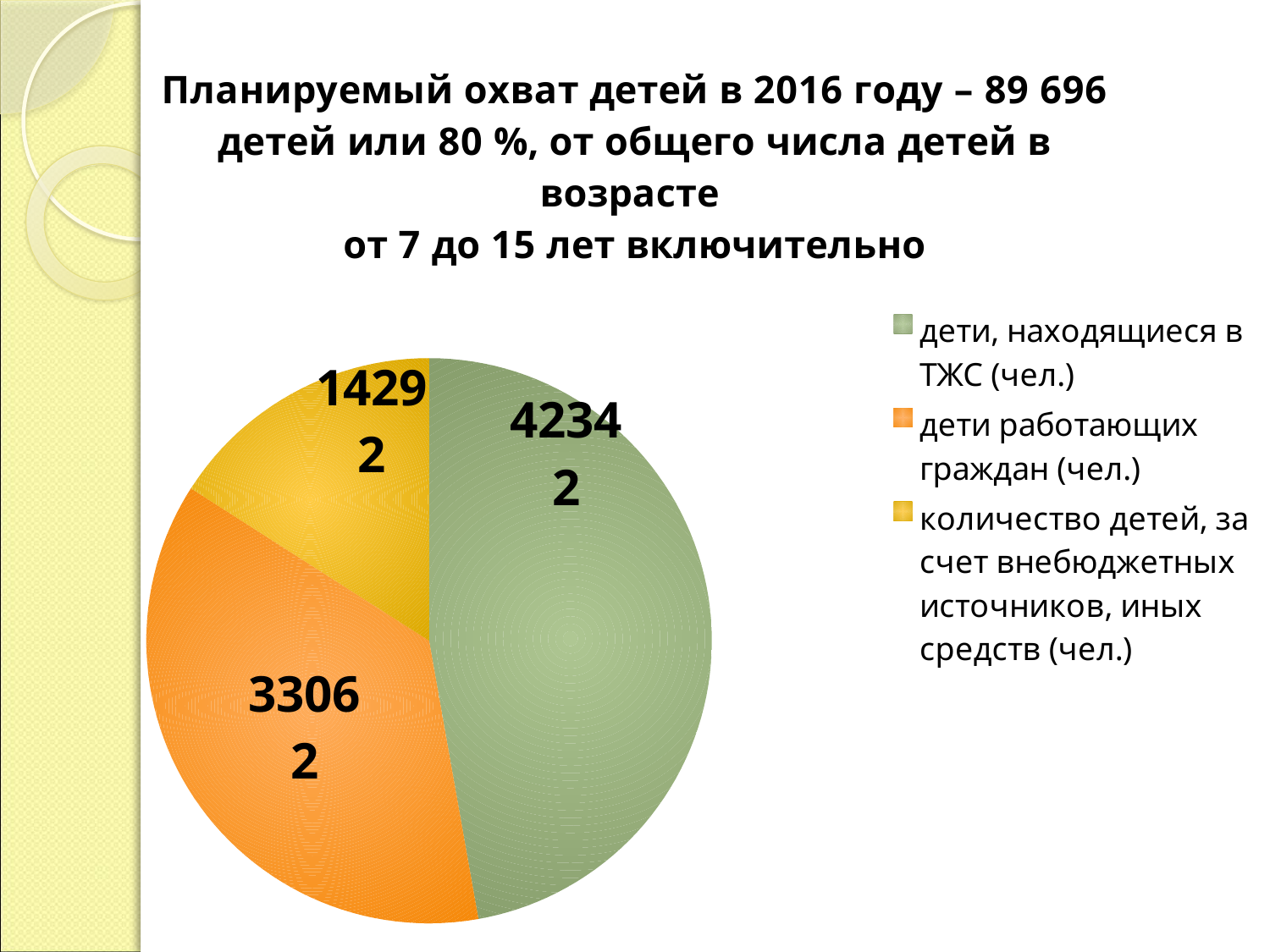
Which is larger: the value for "дети работающих граждан (чел.)" or the value for "количество детей, за счет внебюджетных источников, иных средств (чел.)"? дети работающих граждан (чел.) How many slices does the pie chart have? 3 What is the value for "дети, находящиеся в ТЖС (чел.)"? 42342 What colour is the slice for "дети работающих граждан (чел.)"? orange What kind of chart is shown on the slide? pie chart What is the value for "количество детей, за счет внебюджетных источников, иных средств (чел.)"? 14292 How many entries does the legend list? 3 Which category has the smallest slice of the pie? количество детей, за счет внебюджетных источников, иных средств (чел.) What is the difference between the values for "дети, находящиеся в ТЖС (чел.)" and "дети работающих граждан (чел.)"? 9280 What is the difference between the values for "дети работающих граждан (чел.)" and "количество детей, за счет внебюджетных источников, иных средств (чел.)"? 18770 Which category has the largest slice of the pie? дети, находящиеся в ТЖС (чел.) What is the value for "дети работающих граждан (чел.)"? 33062